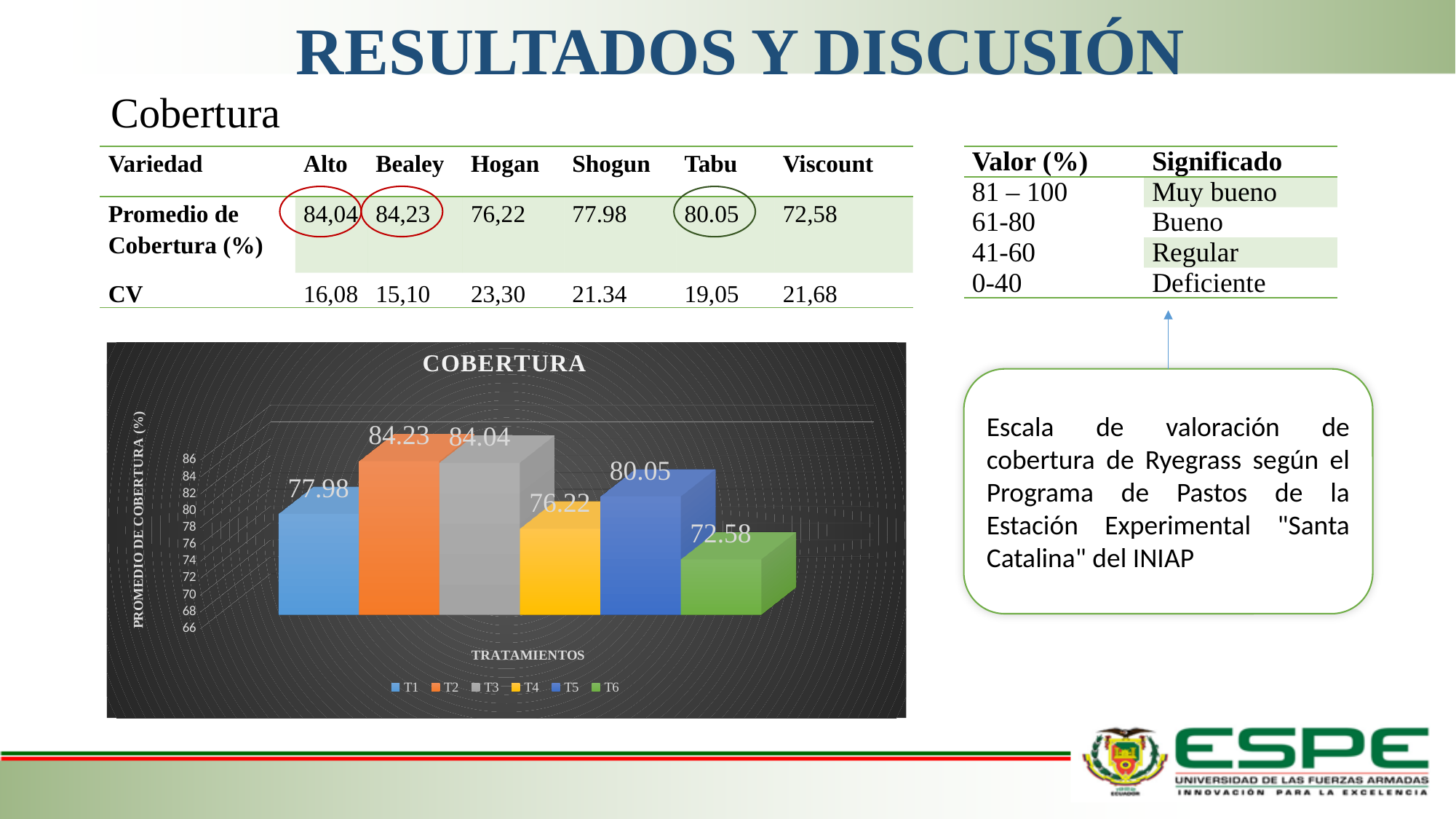
What is the label of the vertical axis of the chart? PROMEDIO DE COBERTURA (%) What is the value of the bar for T2 in the chart? 84.23 What type of chart is shown on the slide? bar chart What is the title of the chart? COBERTURA Which treatment has the lowest value in the chart? T6 Which has a larger value in the chart, T1 or T4? T1 What is the value of the bar for T1 in the chart? 77.98 What is the difference between the values for T5 and T4 in the chart? 3.83 What is the value of the bar for T6 in the chart? 72.58 How many series does the chart legend list? 6 What is the value of the bar for T5 in the chart? 80.05 Which treatment has the highest value in the chart? T2